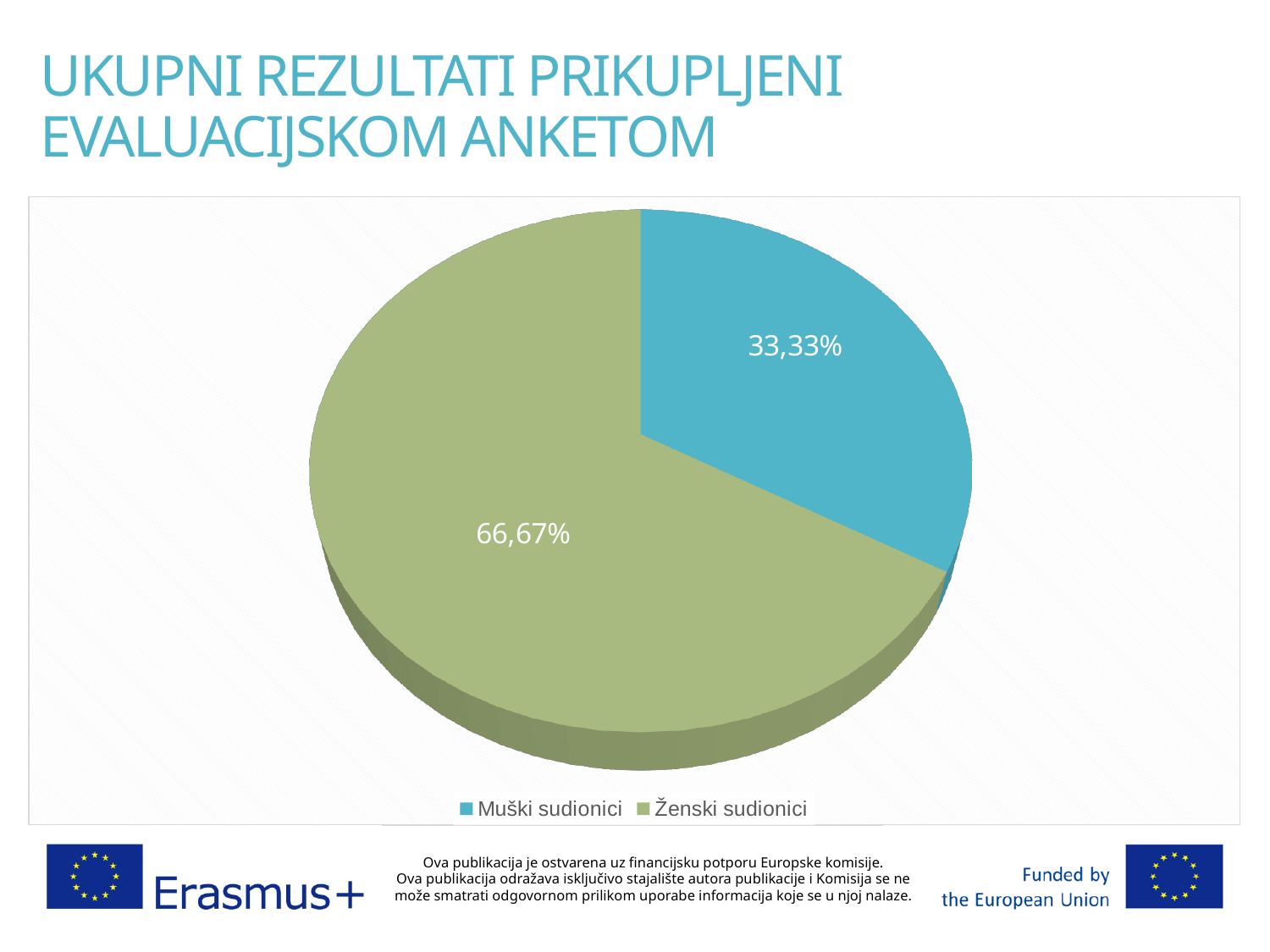
Which category has the smallest slice of the pie? Muški sudionici Where is the legend positioned relative to the pie? below the pie Is the share for Ženski sudionici greater or less than 50%? greater What colour is the slice for Muški sudionici? blue Which is larger, the slice for Muški sudionici or the slice for Ženski sudionici? Ženski sudionici How many entries does the legend list? 2 What kind of chart is shown on the slide? pie chart Which category has the largest slice of the pie? Ženski sudionici What share of the pie does Ženski sudionici represent? 66,67% What share of the pie does Muški sudionici represent? 33,33% How many slices does the pie chart have? 2 What is the difference in percentage points between the Ženski sudionici slice and the Muški sudionici slice? 33,34